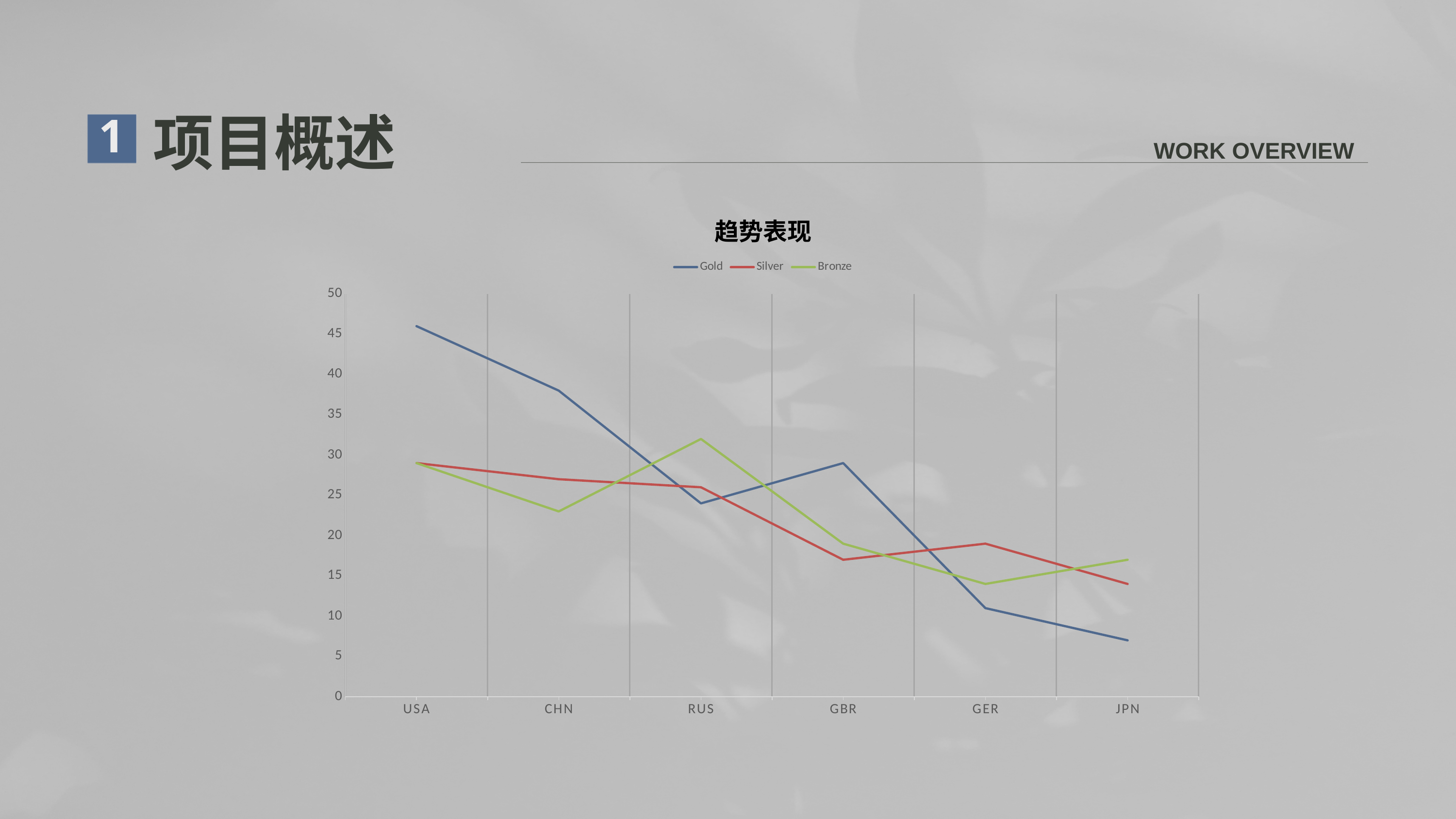
How many categories are shown on the x axis? 6 Does the Gold line generally rise or fall from USA to JPN? fall Is the Gold value for JPN greater or less than 10? less How many series does the legend list? 3 Which is larger for CHN, the Gold value or the Silver value? Gold Which is larger for RUS, the Bronze value or the Gold value? Bronze Is the Bronze value for RUS greater or less than 30? greater What kind of chart is shown on the slide? line chart Is the Gold value for USA greater or less than 40? greater Which category has the highest Gold value? USA Which category has the lowest Gold value? JPN What is the title of the chart? 趋势表现